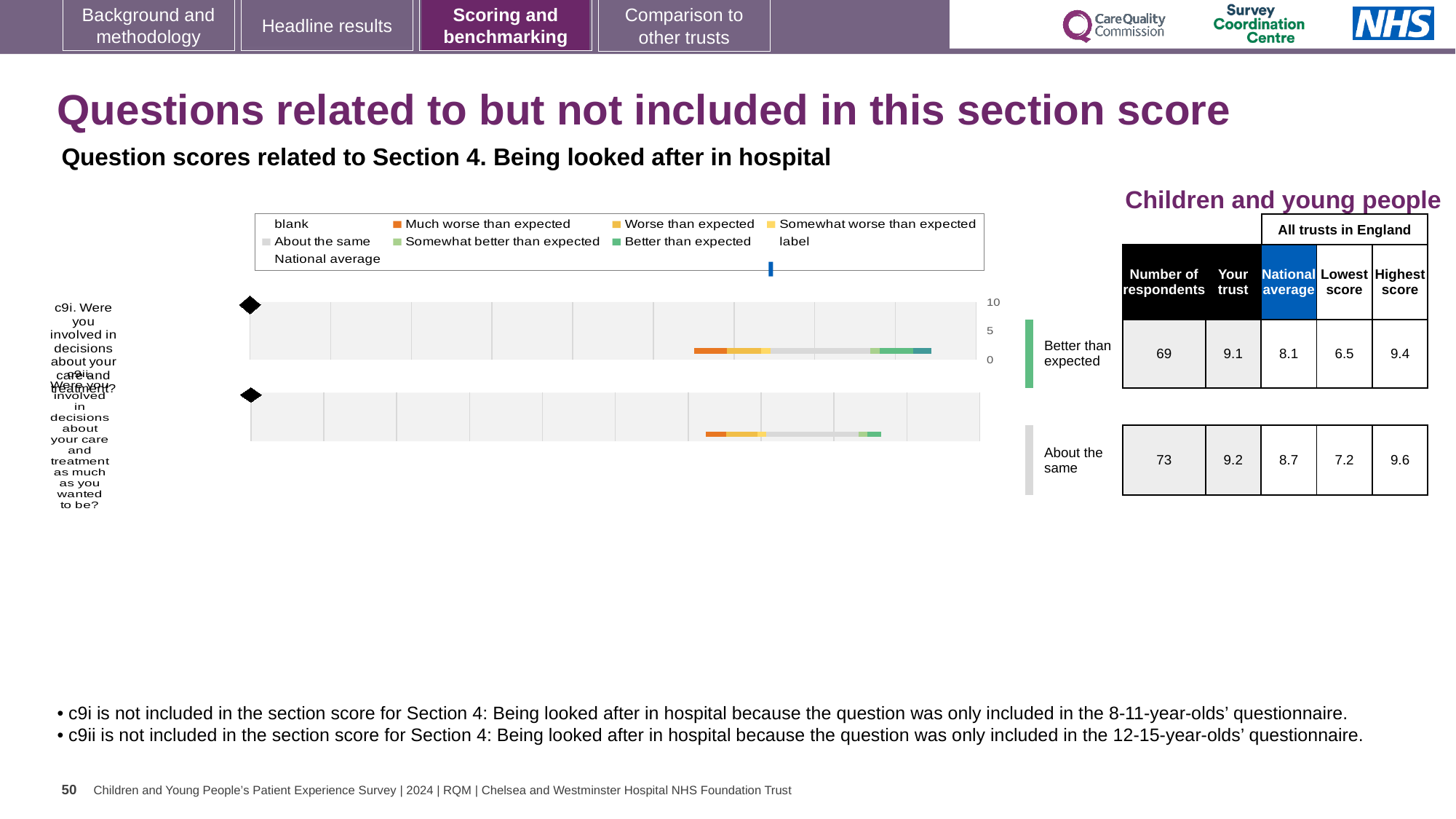
How many questions (bars) are plotted in the chart? 2 How many entries does the chart legend list? 9 What kind of chart is used to show the question scores for c9i and c9ii? bar chart In the table, which question has the higher 'Your trust' score, c9i or c9ii? c9ii What is the highest value shown on the chart's axis? 10 In the table, what is the 'Your trust' score for c9ii (About the same)? 9.2 In the table, what is the Number of respondents for c9ii? 73 In the table, what is the Highest score for c9ii? 9.6 In the table, what is the National average for c9i? 8.1 In the table, what is the difference between the Highest score and Lowest score for c9i? 2.9 Which legend entry is shown in dark orange? Much worse than expected In the table, what is the 'Your trust' score for c9i (Better than expected)? 9.1